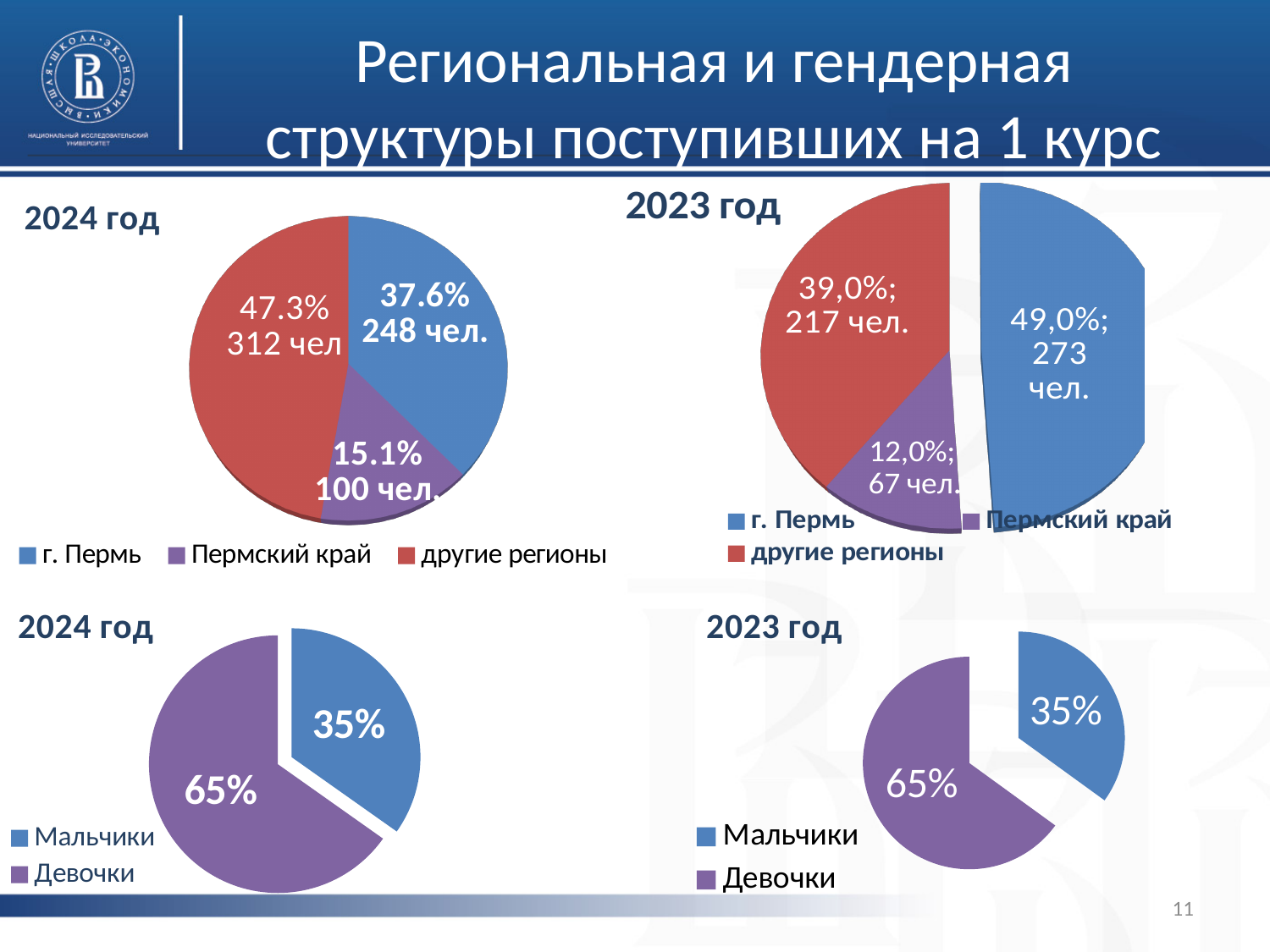
In the top-left pie chart (2024 год, regional structure), which category has the smallest share? Пермский край In the top-right pie chart (2023 год, regional structure), how many people are in the Пермский край slice? 67 чел. In the bottom-left pie chart (2024 год, gender structure), what share is shown for Девочки? 65% In the bottom-right pie chart (2023 год, gender structure), what share is shown for Мальчики? 35% In the top-right pie chart (2023 год, regional structure), what is the difference in people between г. Пермь and другие регионы? 56 чел. In the top-right pie chart (2023 год, regional structure), what share is shown for г. Пермь? 49,0% In the top-left pie chart (2024 год, regional structure), what share is shown for г. Пермь? 37.6% In the top-left pie chart (2024 год, regional structure), how many people are in the другие регионы slice? 312 чел How many categories does the legend of the top-left pie chart (2024 год, regional structure) list? 3 In the top-right pie chart (2023 год, regional structure), which category has the largest share? г. Пермь What type of chart is used for the bottom-left chart (2024 год, gender structure)? Pie chart In the top-left pie chart (2024 год, regional structure), which is larger: the share for г. Пермь or for другие регионы? другие регионы